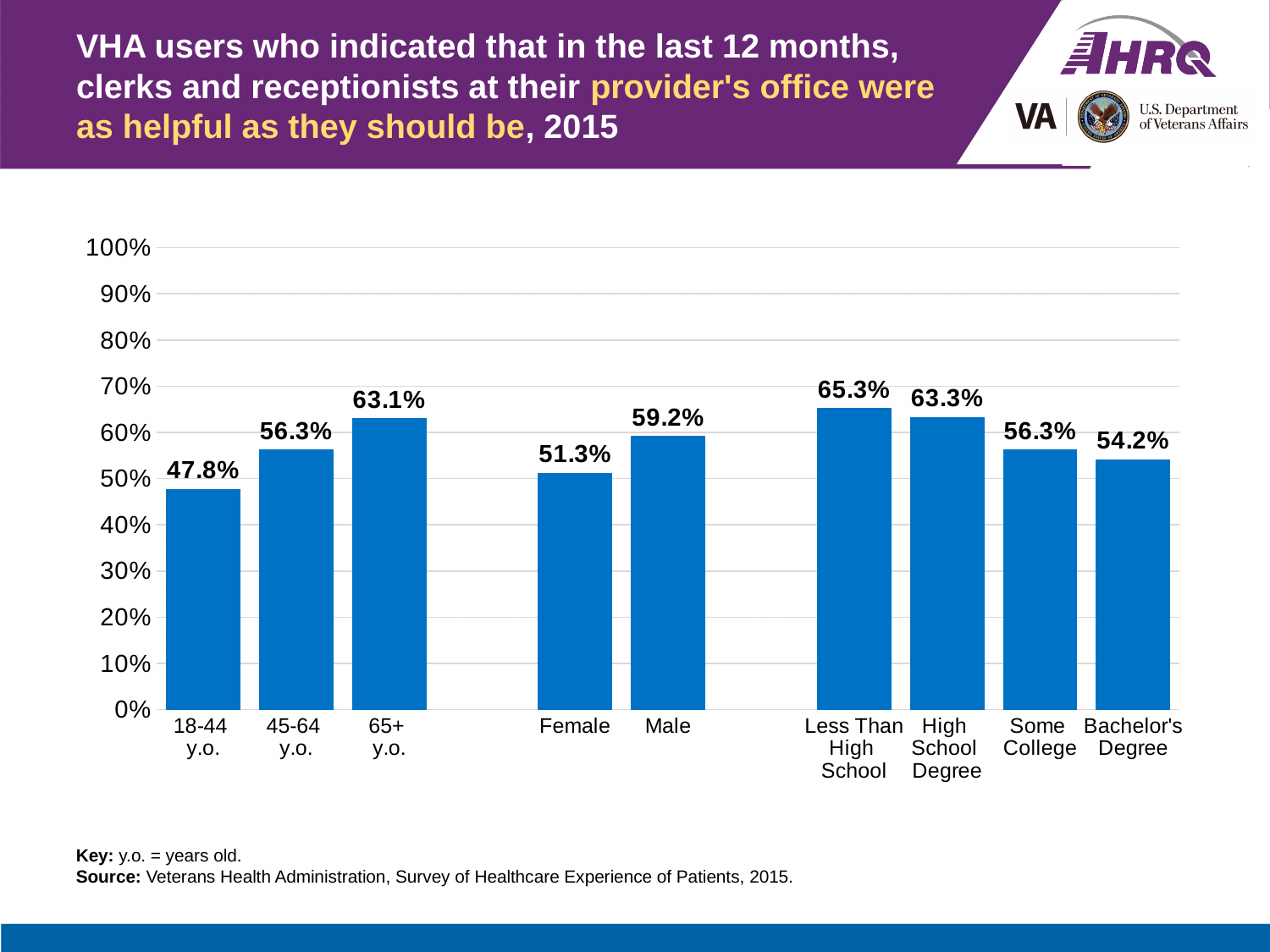
What is the value for VHA users with Less Than High School education? 65.3% Which is larger, the value for High School Degree or the value for Some College? High School Degree What is the difference between the values for 65+ y.o. and 18-44 y.o.? 15.3% Is the value for Female VHA users greater or less than 60%? less What is the difference between the values for Male and Female VHA users? 7.9% Which category has the lowest value on the chart? 18-44 y.o. What is the value for Male VHA users? 59.2% How many categories are shown on the chart? 9 What kind of chart is shown on the slide? Bar chart What is the value for VHA users with a Bachelor's Degree? 54.2% Which category has the highest value on the chart? Less Than High School What is the value for VHA users aged 18-44 y.o.? 47.8%